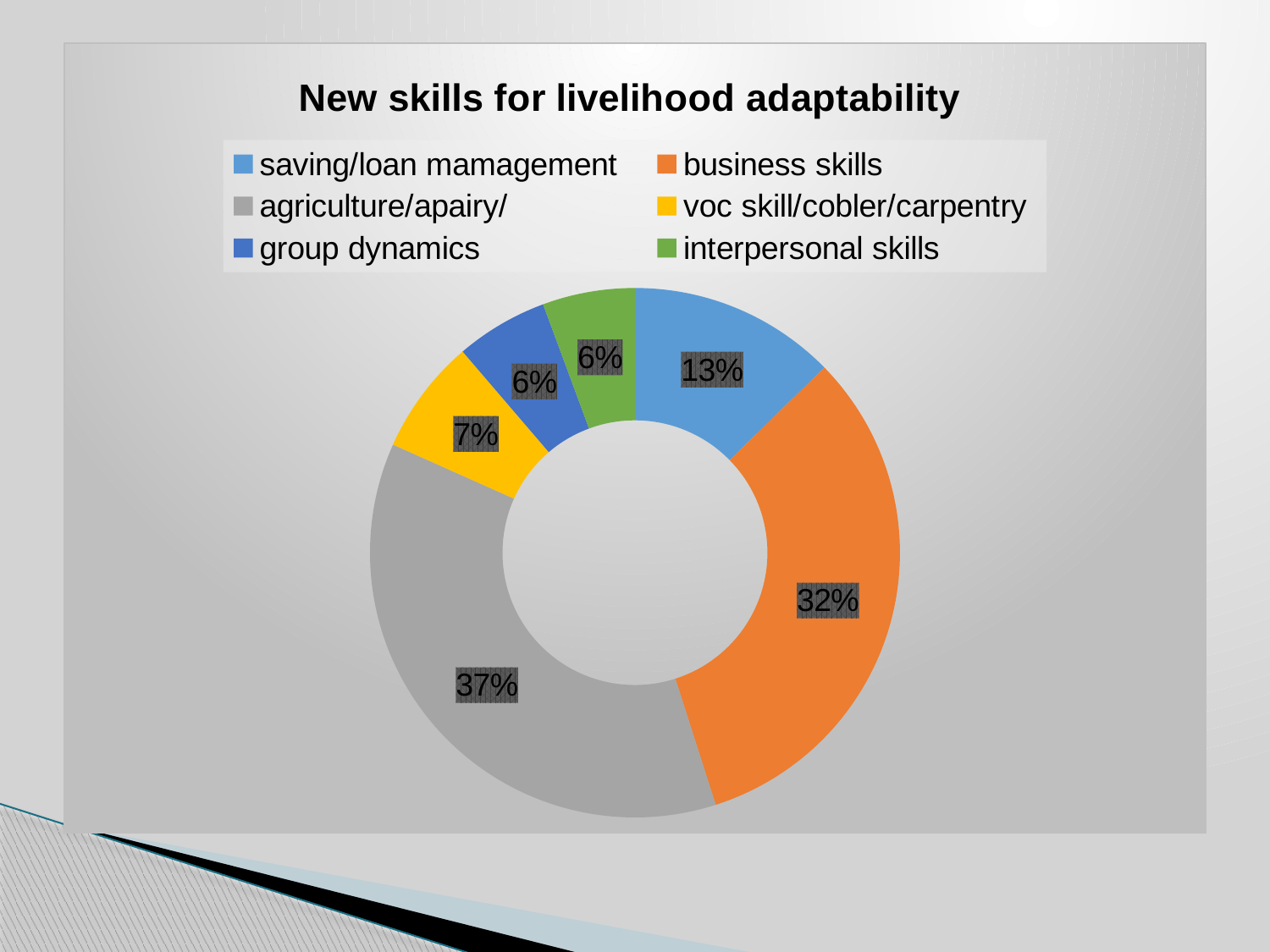
What colour represents business skills in the chart? Orange Which is larger, the share for saving/loan mamagement or the share for voc skill/cobler/carpentry? saving/loan mamagement What percentage is shown for business skills? 32% What percentage is shown for agriculture/apairy/? 37% What is the difference between the shares for agriculture/apairy/ and business skills? 5% What percentage is shown for group dynamics? 6% What kind of chart is shown on the slide? Doughnut chart What percentage is shown for saving/loan mamagement? 13% What percentage is shown for voc skill/cobler/carpentry? 7% Which category has the largest share of the chart? agriculture/apairy/ How many categories does the legend list? 6 What is the title of the chart? New skills for livelihood adaptability